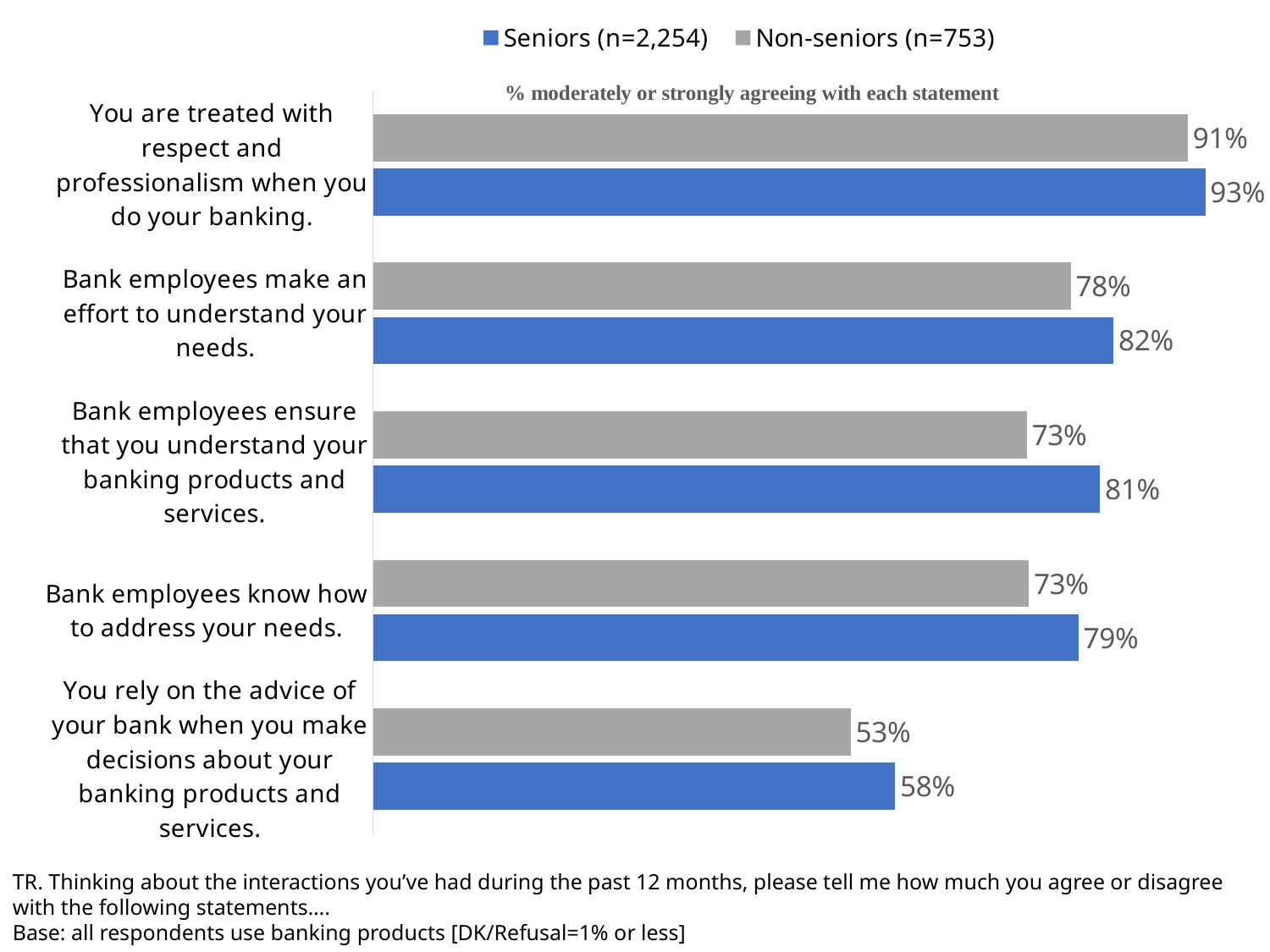
What percentage of Seniors agree that they are treated with respect and professionalism when they do their banking? 93% What is the difference between Seniors and Non-seniors agreeing that bank employees ensure they understand their banking products and services? 8 percentage points How many series does the legend list? 2 What percentage of Non-seniors agree that bank employees know how to address their needs? 73% Which statement has the highest level of agreement among Seniors? You are treated with respect and professionalism when you do your banking. How many statements are shown in the chart? 5 What is the sample size for the Non-seniors group shown in the legend? 753 Which group has a higher share agreeing that bank employees know how to address their needs, Seniors or Non-seniors? Seniors What percentage of Seniors agree that they rely on the advice of their bank when making decisions about banking products and services? 58% What percentage of Non-seniors agree that bank employees make an effort to understand their needs? 78% Which statement has the lowest level of agreement among Non-seniors? You rely on the advice of your bank when you make decisions about your banking products and services. What type of chart is shown on the slide? Bar chart